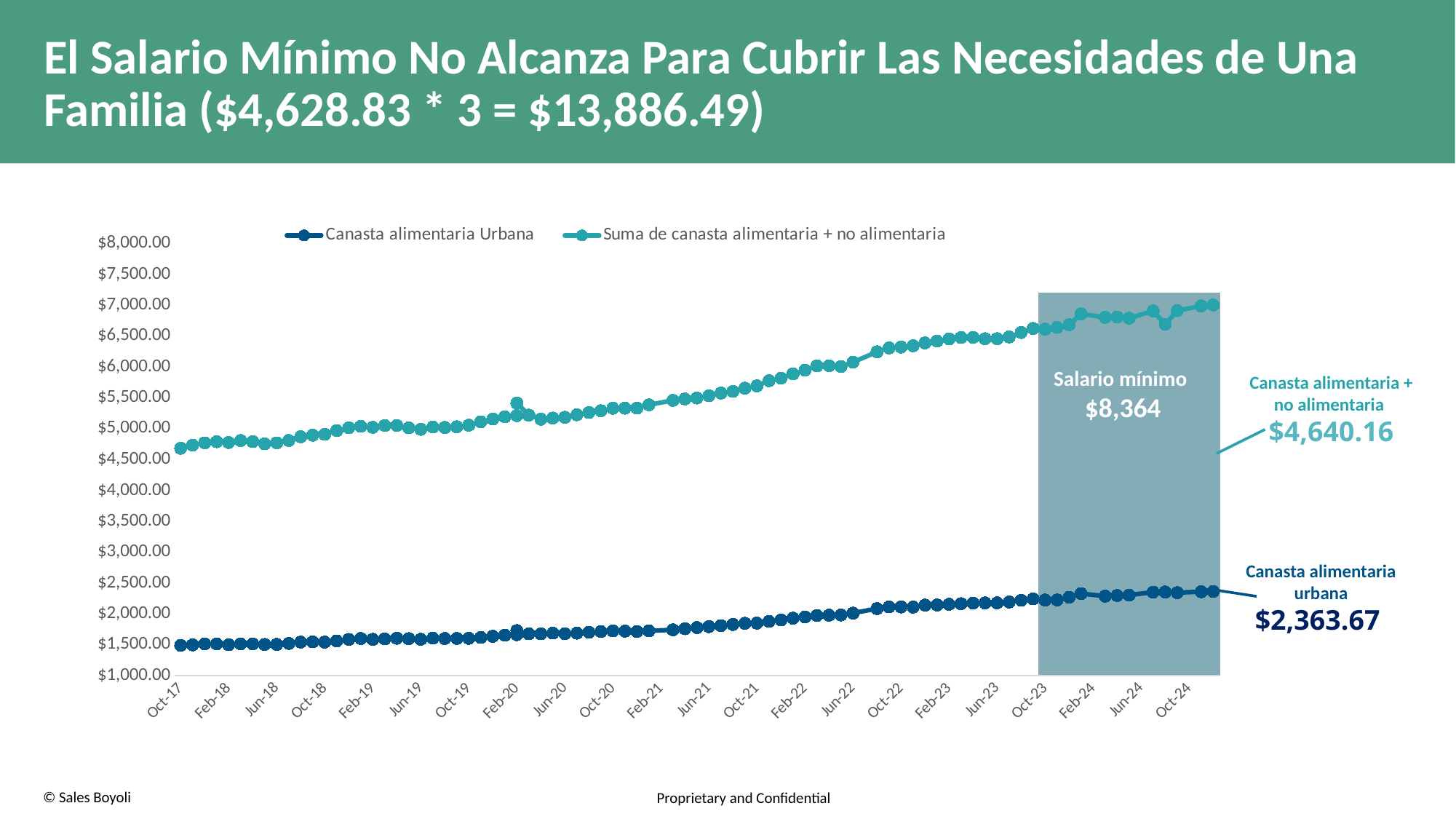
Which series is plotted higher on the chart, Canasta alimentaria Urbana or Suma de canasta alimentaria + no alimentaria? Suma de canasta alimentaria + no alimentaria Is the value for Suma de canasta alimentaria + no alimentaria at Oct-24 greater or less than $6,500.00? greater What are the two series named in the chart legend? Canasta alimentaria Urbana; Suma de canasta alimentaria + no alimentaria Do the values of the Suma de canasta alimentaria + no alimentaria series rise or fall from Oct-17 to Oct-24? Rise What Salario mínimo value is shown in the shaded region of the chart? $8,364 Is the value for Canasta alimentaria Urbana at Oct-17 greater or less than $2,000.00? less What is the difference between the annotated values for Canasta alimentaria + no alimentaria ($4,640.16) and Canasta alimentaria urbana ($2,363.67)? $2,276.49 Is the value for Suma de canasta alimentaria + no alimentaria at Oct-17 greater or less than $5,000.00? less What type of chart is shown on the slide? Line chart What value does the annotation on the right give for Canasta alimentaria + no alimentaria? $4,640.16 How many series does the chart legend list? 2 What value does the annotation on the right give for Canasta alimentaria urbana? $2,363.67